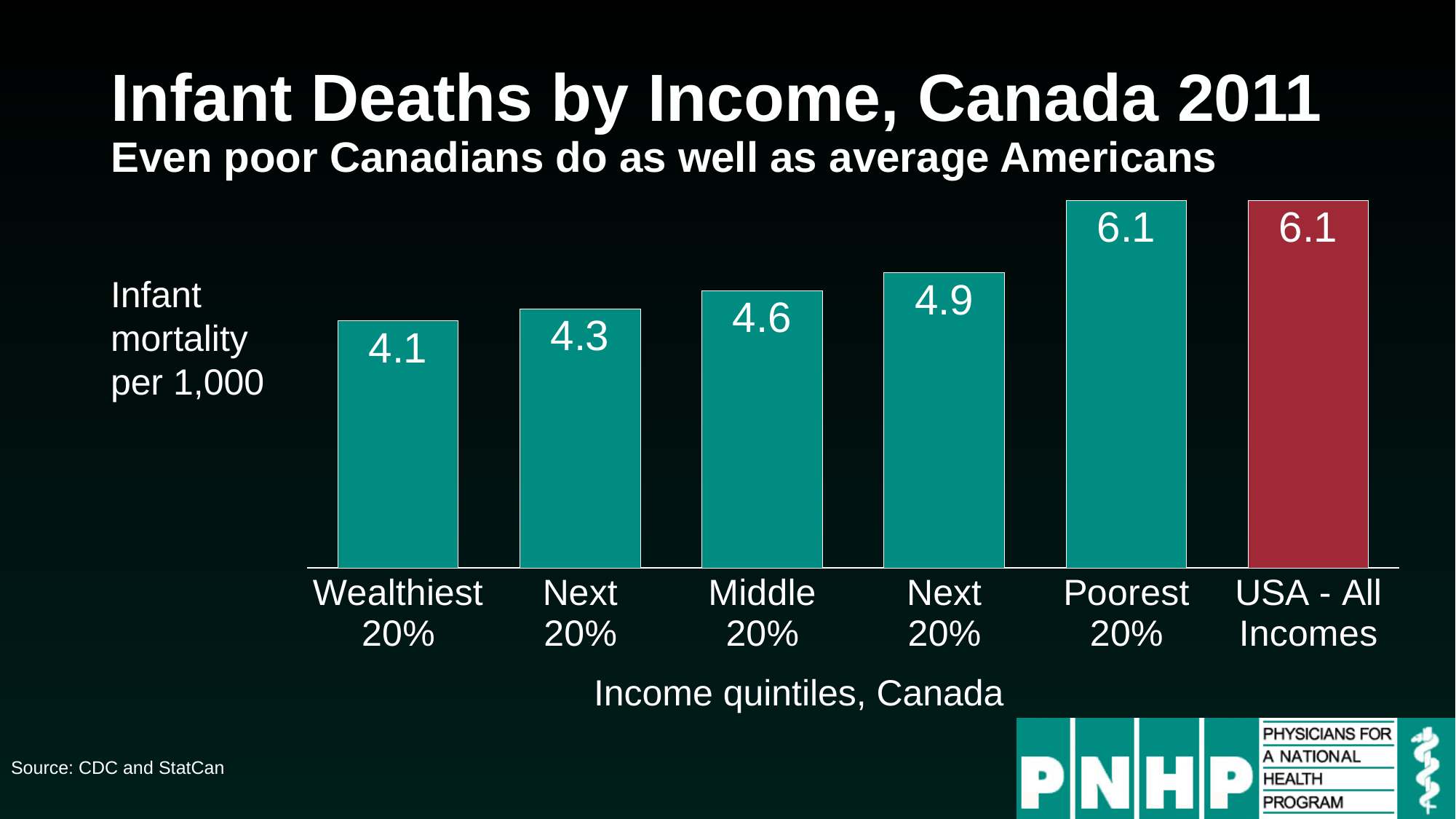
Do infant mortality values rise or fall moving from the Wealthiest 20% to the Poorest 20% quintile? Rise Which bar is shown in a different colour (red) from the others? USA - All Incomes What type of chart is shown on the slide? Bar chart What is the infant mortality per 1,000 shown for USA - All Incomes? 6.1 What is the infant mortality per 1,000 for the Wealthiest 20% income quintile? 4.1 What is the infant mortality per 1,000 for the Middle 20% income quintile? 4.6 What is the infant mortality per 1,000 for the Poorest 20% income quintile in Canada? 6.1 How many bars are shown in the chart? 6 Which category has the lowest infant mortality per 1,000? Wealthiest 20% What is the difference in infant mortality per 1,000 between the Poorest 20% and the Wealthiest 20% in Canada? 2.0 Which has a higher infant mortality per 1,000: the Middle 20% or the Wealthiest 20%? Middle 20% What is the difference in infant mortality per 1,000 between the Next 20% (fourth bar) and the Middle 20%? 0.3